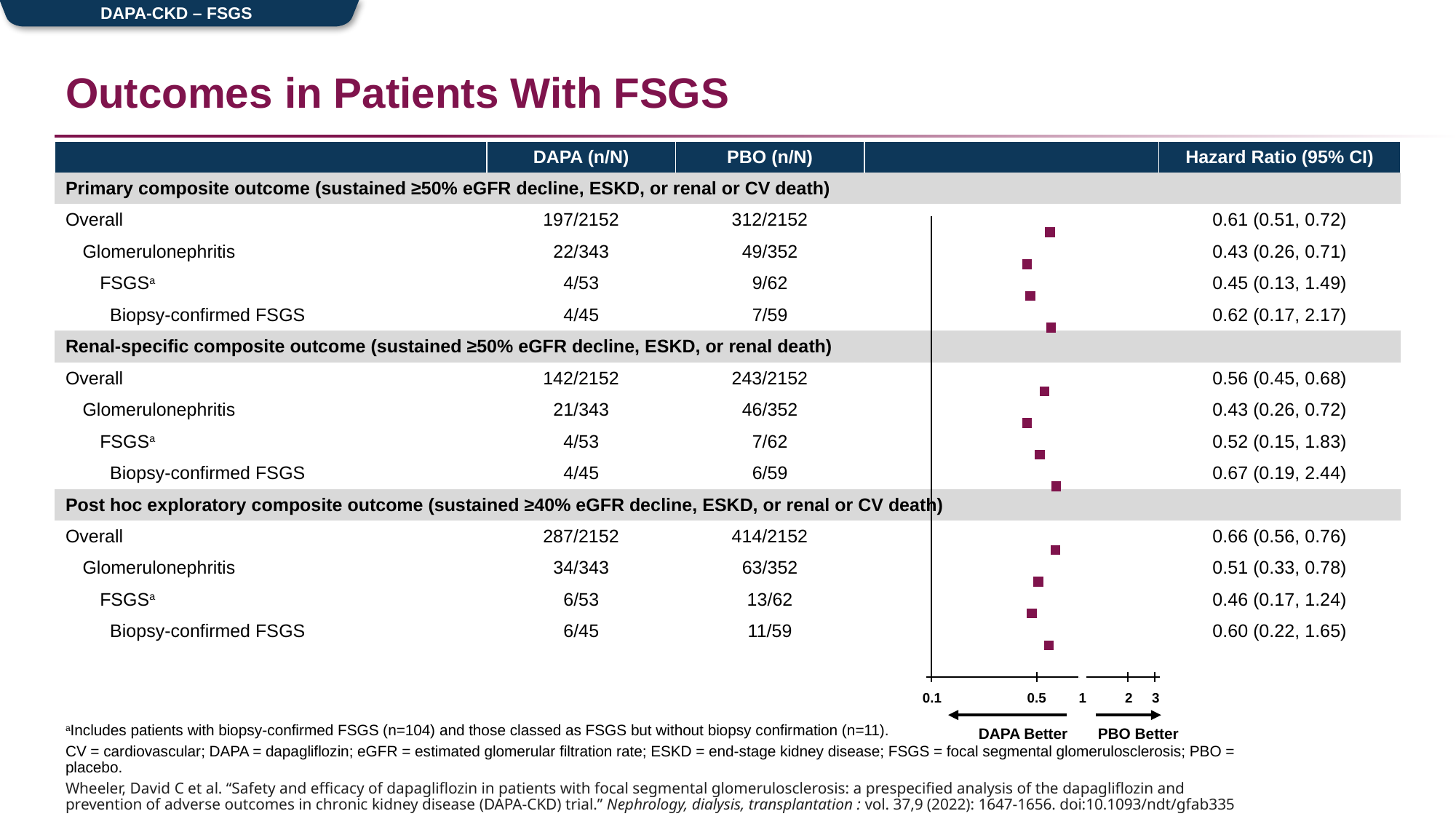
How many hazard ratio points are plotted in the forest plot? 12 Which side of the forest plot axis is labelled 'DAPA Better'? Left What kind of chart is shown on the slide? Forest plot What is the largest tick value shown on the forest plot's x axis? 3 For the post hoc exploratory composite outcome, which has the larger hazard ratio point estimate: Overall or FSGS? Overall What is the hazard ratio for FSGS for the post hoc exploratory composite outcome? 0.46 (0.17, 1.24) What is the hazard ratio for the Overall group for the primary composite outcome? 0.61 (0.51, 0.72) Within the primary composite outcome, which subgroup has the lowest hazard ratio point estimate? Glomerulonephritis Within the renal-specific composite outcome, which subgroup has the highest hazard ratio point estimate? Biopsy-confirmed FSGS Is the hazard ratio point estimate for Biopsy-confirmed FSGS in the renal-specific composite outcome greater or less than 1? less For the primary composite outcome, what is the difference between the hazard ratio point estimates for Overall and Glomerulonephritis? 0.18 What is the hazard ratio for Biopsy-confirmed FSGS for the renal-specific composite outcome? 0.67 (0.19, 2.44)